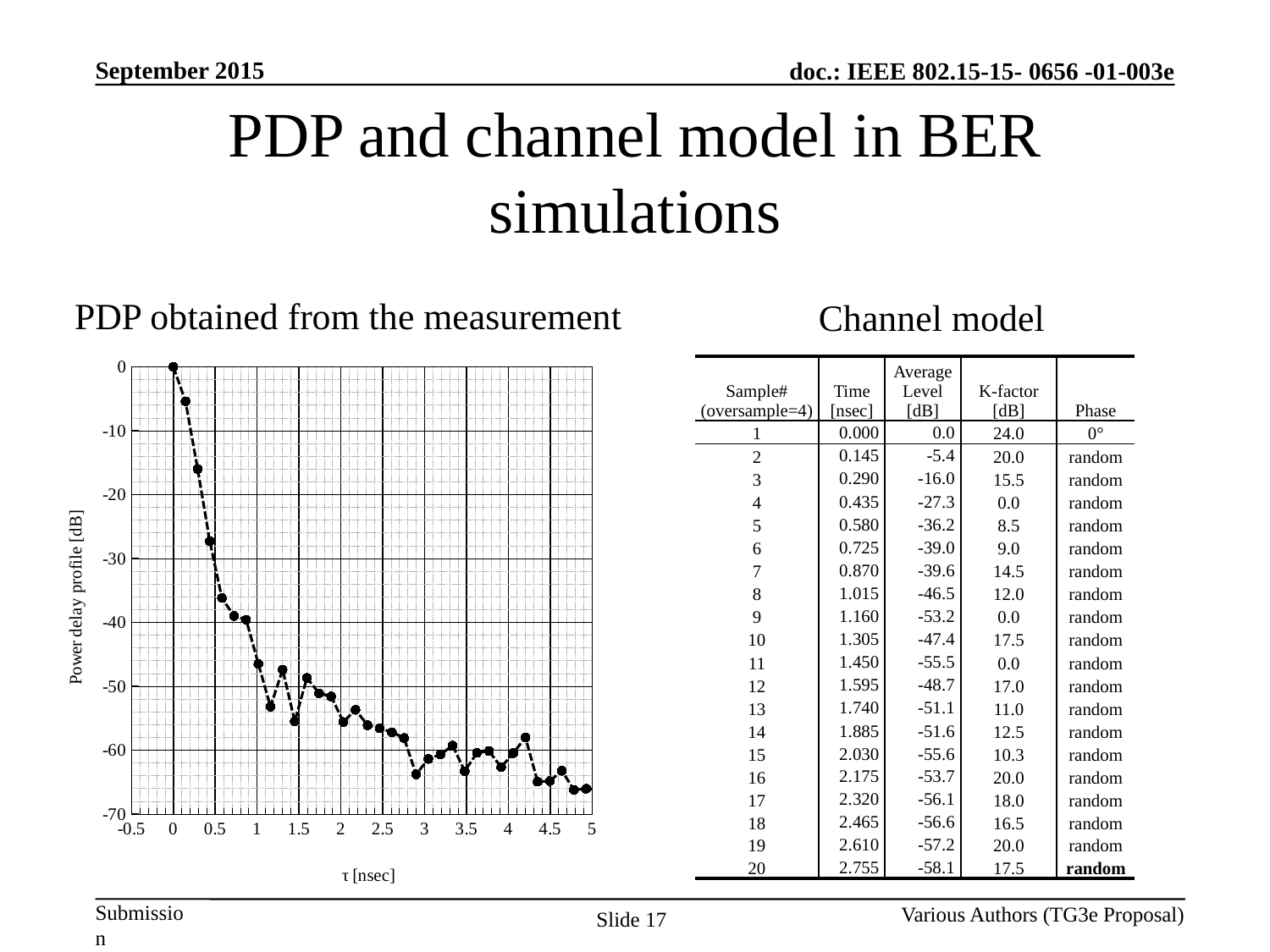
At which τ value is the power delay profile highest? 0 Is the power delay profile value at τ = 0.5 nsec greater or less than -20 dB? less Is the power delay profile value at τ = 4.5 nsec greater or less than -60 dB? less What kind of chart is shown on the slide? line chart Which is larger, the power delay profile value at τ = 0.5 nsec or at τ = 1.5 nsec? τ = 0.5 nsec Is the power delay profile value at τ = 1 nsec greater or less than -30 dB? less What is the label of the x axis of the chart? τ [nsec] Do the power delay profile values generally rise or fall as τ increases? fall Which is larger, the power delay profile value at τ = 1 nsec or at τ = 2 nsec? τ = 1 nsec What is the label of the y axis of the chart? Power delay profile [dB] What is the power delay profile value at τ = 0 nsec? 0